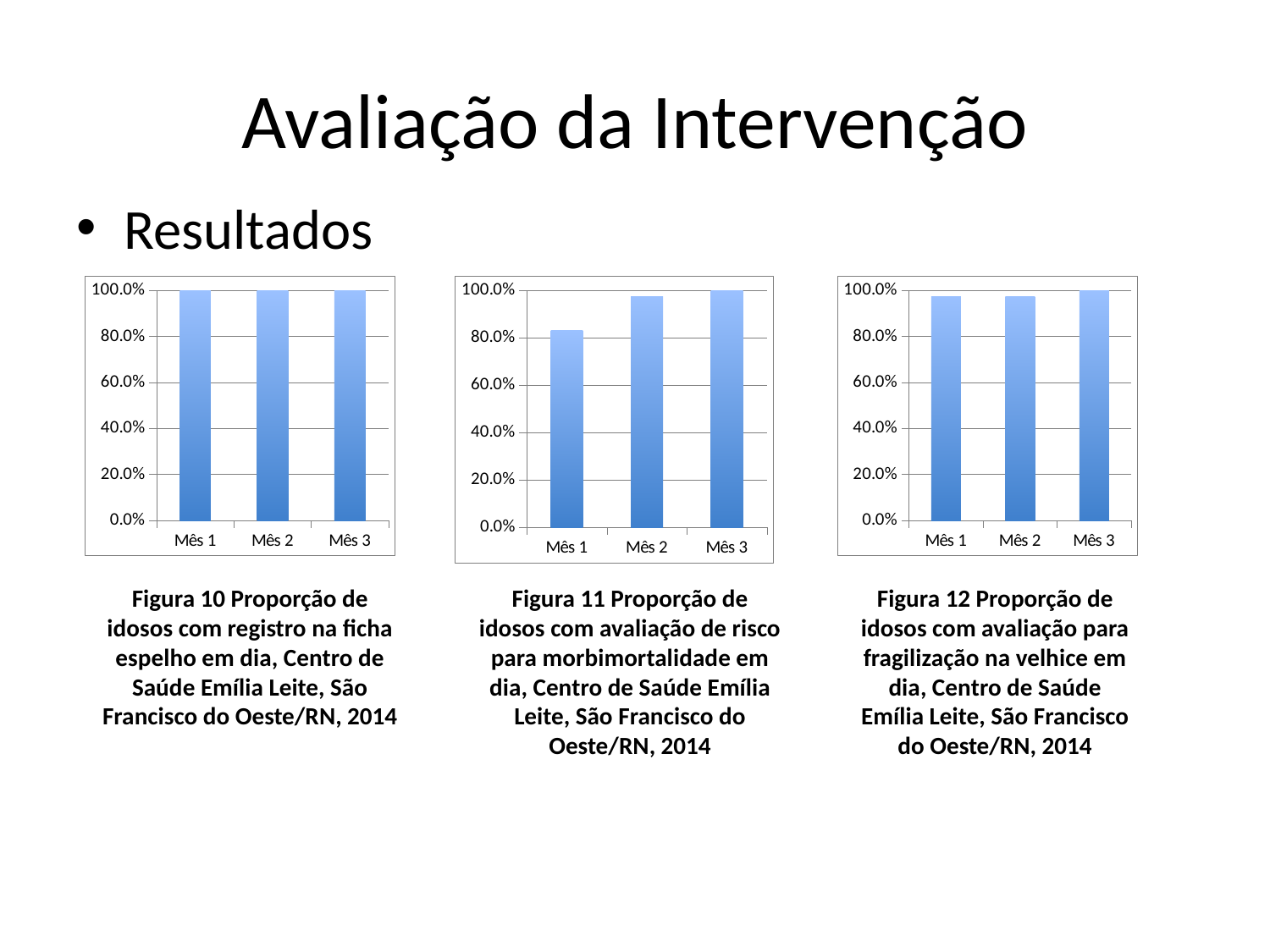
In the chart for Figura 11 (middle), do the values rise or fall from Mês 1 to Mês 3? rise What kind of chart is used for Figura 12 (right)? bar chart In the chart for Figura 12 (right), what is the value for Mês 3? 100.0% In the chart for Figura 10 (left), what is the value for Mês 1? 100.0% How many categories are shown on the x axis of the chart for Figura 10 (left)? 3 In the chart for Figura 11 (middle), is the value for Mês 1 greater or less than 100.0%? less In the chart for Figura 11 (middle), what is the value for Mês 3? 100.0% In the chart for Figura 12 (right), is the value for Mês 1 greater or less than 80.0%? greater In the chart for Figura 11 (middle), is the value for Mês 1 greater or less than 80.0%? greater How many charts are shown on the slide? 3 In the chart for Figura 11 (middle), which is larger, the value for Mês 1 or Mês 2? Mês 2 In the chart for Figura 11 (middle), which month has the lowest value? Mês 1